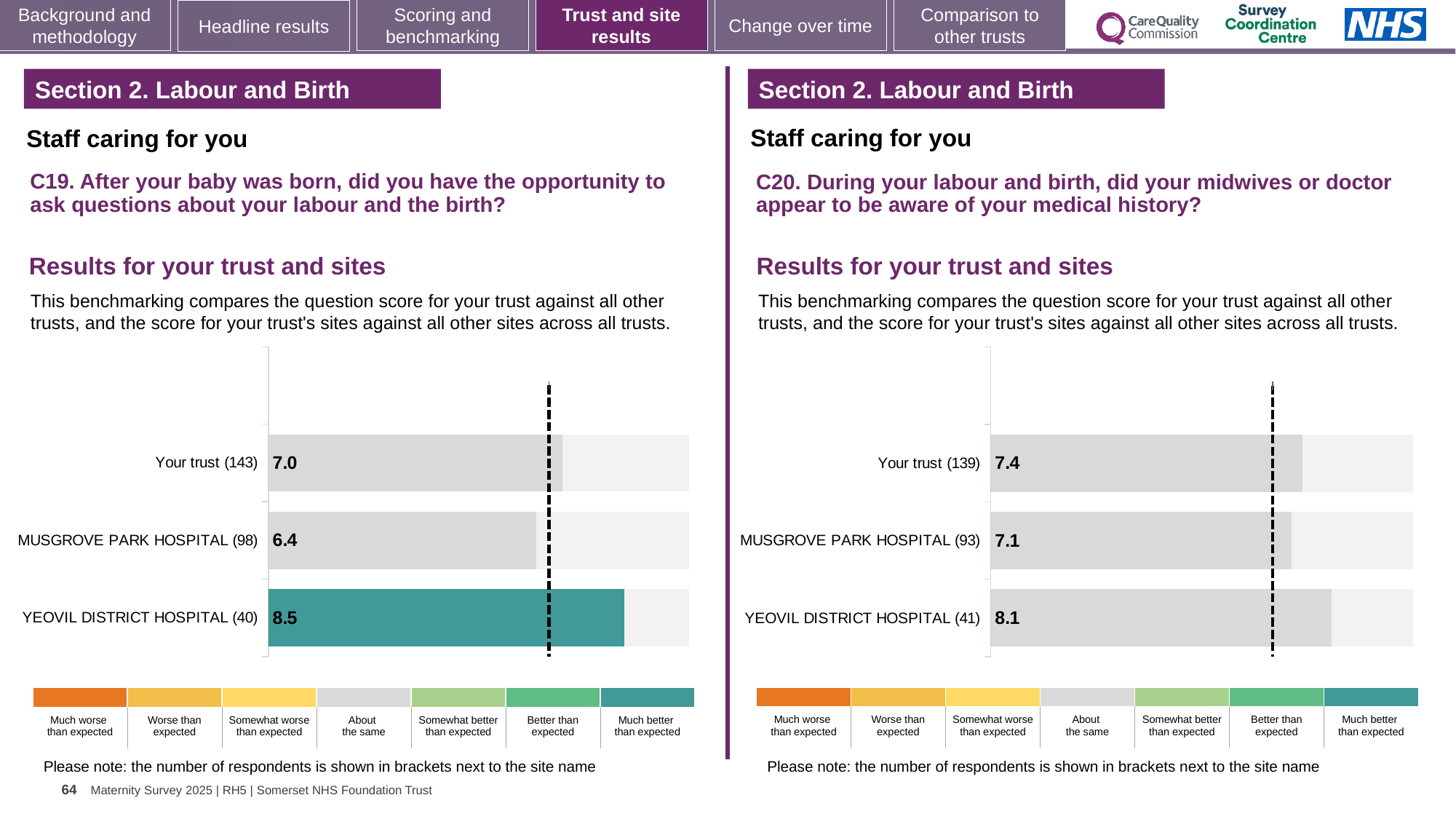
In the C20 chart on the right, what is the score for Your trust? 7.4 In the C20 chart on the right, which site or trust has the lowest score? Musgrove Park Hospital In the C20 chart on the right, what is the difference between the scores for Yeovil District Hospital and Your trust? 0.7 How many bars are plotted in the C19 chart on the left? 3 In the C19 chart on the left, what is the difference between the scores for Yeovil District Hospital and Musgrove Park Hospital? 2.1 In the C19 chart on the left, which site or trust has the lowest score? Musgrove Park Hospital In the C19 chart on the left, what is the score for Your trust? 7.0 What type of chart is used in the C20 chart on the right? Bar chart In the C20 chart on the right, what is the score for Yeovil District Hospital? 8.1 In the C19 chart on the left, what is the score for Musgrove Park Hospital? 6.4 In the C20 chart on the right, which is larger, the score for Your trust or the score for Musgrove Park Hospital? Your trust In the C19 chart on the left, which site or trust has the highest score? Yeovil District Hospital